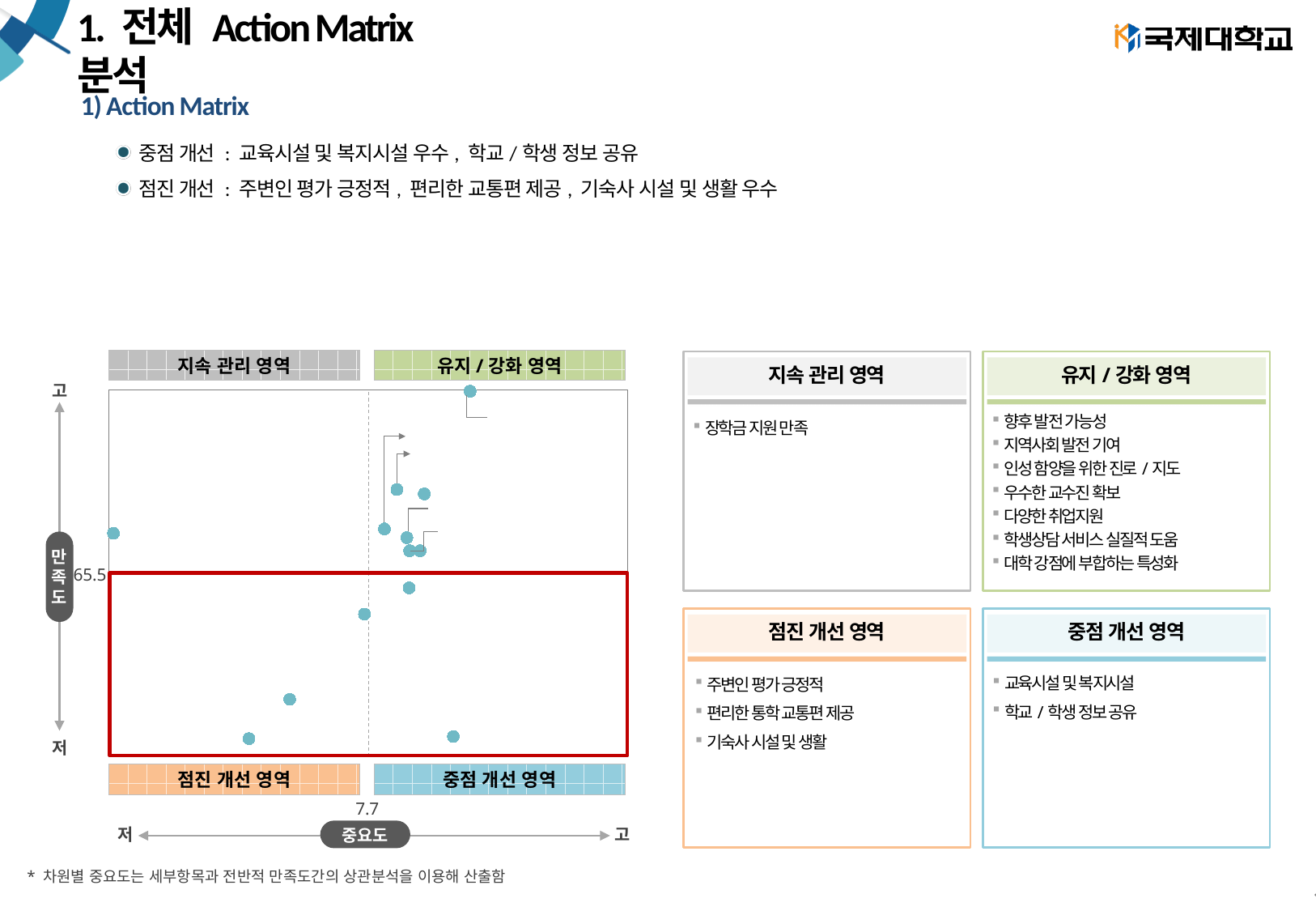
In the Action Matrix chart, what value marks the dividing line on the satisfaction (만족도) axis? 65.5 Which quadrant of the Action Matrix chart is outlined with a red border? Both bottom quadrants: 점진 개선 영역 and 중점 개선 영역 What is the label of the horizontal axis of the Action Matrix chart? 중요도 How many data points fall in the 점진 개선 영역 (bottom-left quadrant) of the Action Matrix chart? 3 What kind of chart is the Action Matrix on the left of the slide? scatter chart How many data points fall in the 지속 관리 영역 (top-left quadrant) of the Action Matrix chart? 1 How many data points fall in the 중점 개선 영역 (bottom-right quadrant) of the Action Matrix chart? 2 In the Action Matrix chart, what value marks the dividing line on the importance (중요도) axis? 7.7